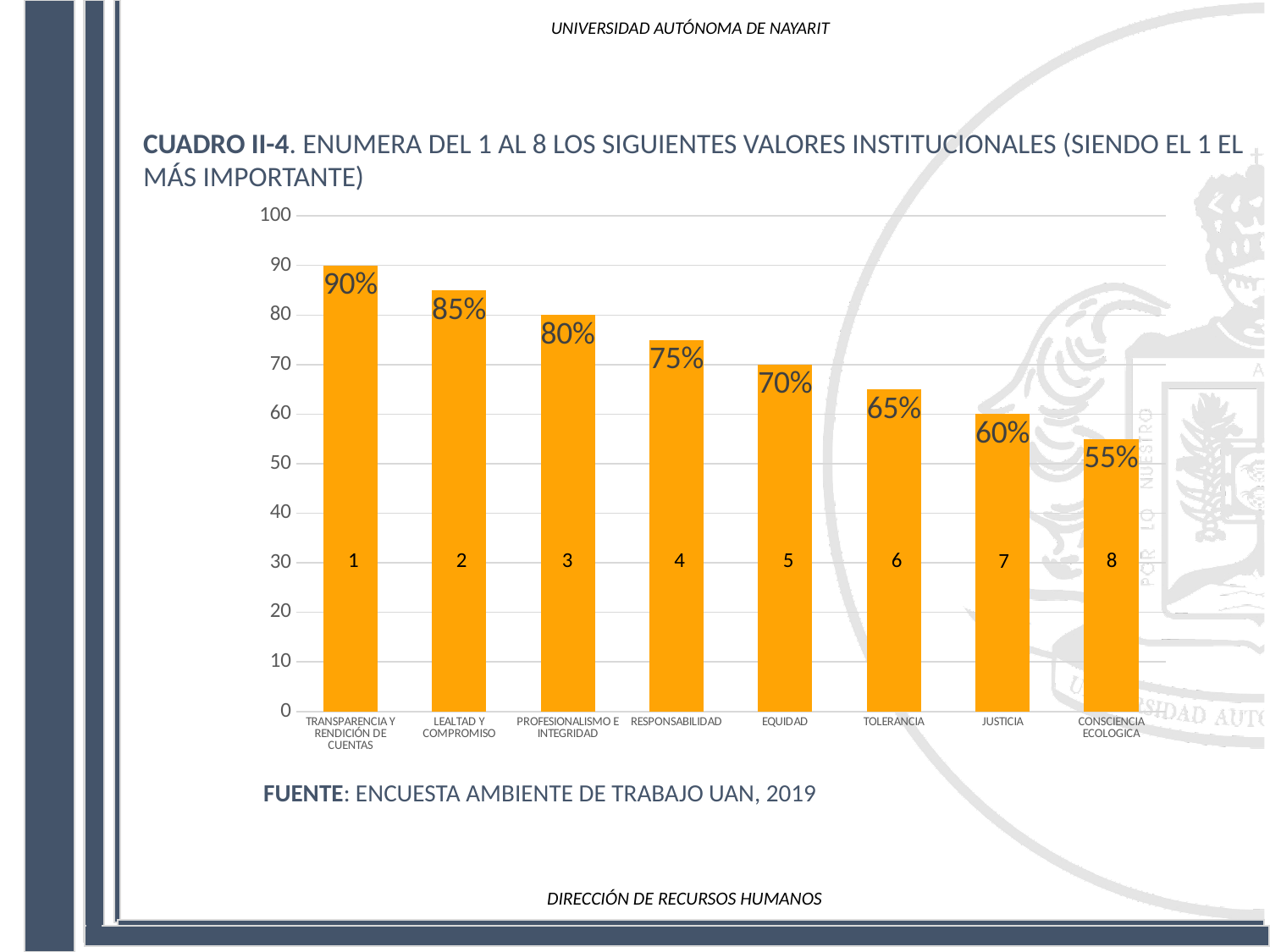
What is the difference between the values for LEALTAD Y COMPROMISO and JUSTICIA? 25% What is the value for TOLERANCIA? 65% Which category has the highest value? TRANSPARENCIA Y RENDICIÓN DE CUENTAS Which category has the lowest value? CONSCIENCIA ECOLOGICA Is the value for PROFESIONALISMO E INTEGRIDAD greater or less than 70? greater What is the value for TRANSPARENCIA Y RENDICIÓN DE CUENTAS? 90% Which is larger, the value for RESPONSABILIDAD or the value for TOLERANCIA? RESPONSABILIDAD What kind of chart is shown on the slide? Bar chart How many categories are shown in the chart? 8 What is the value for CONSCIENCIA ECOLOGICA? 55% What is the value for EQUIDAD? 70% Do the values rise or fall from left to right along the x axis? Fall